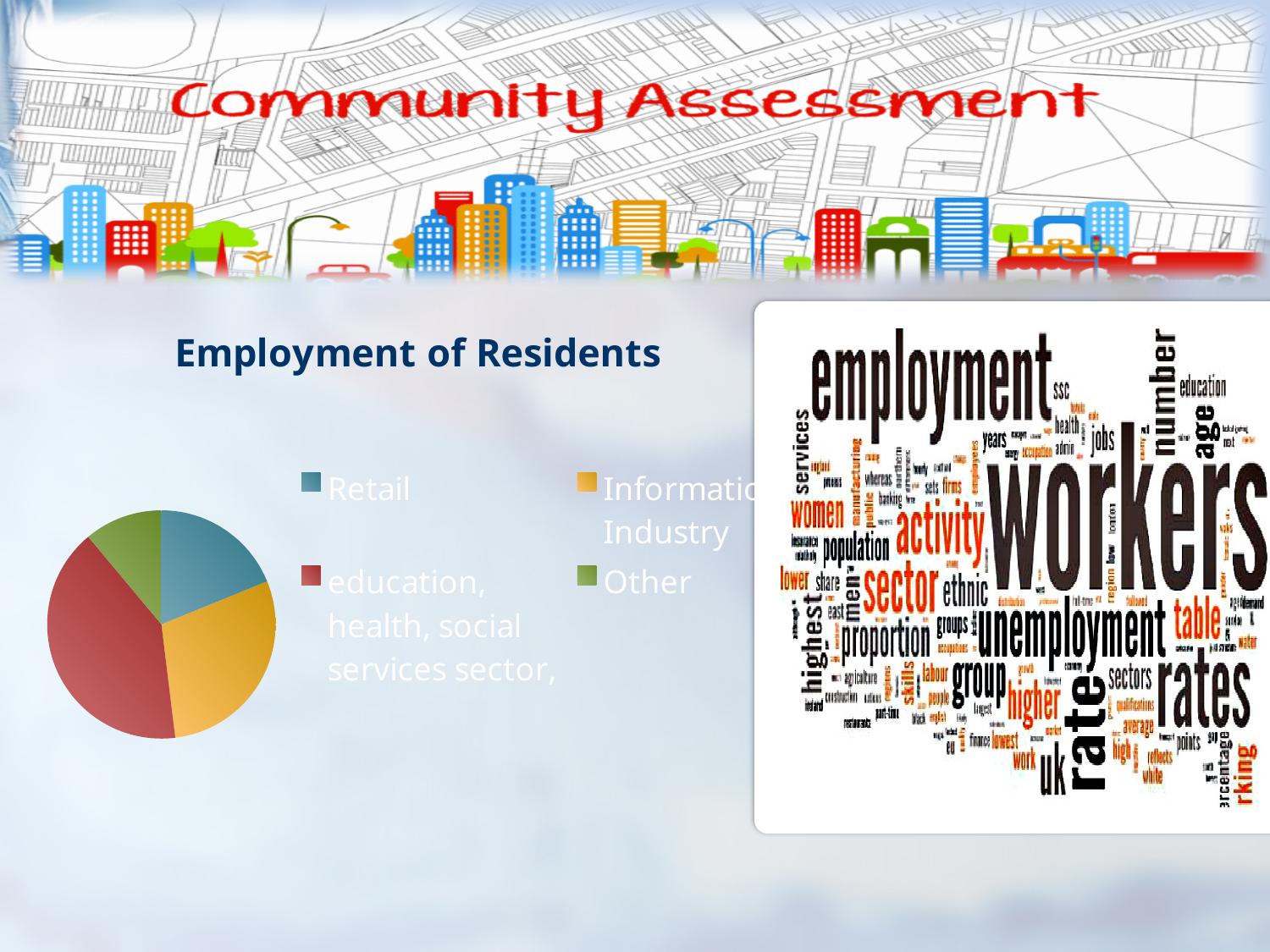
Which category has the smallest slice in the pie chart? Other Which slice is larger: education, health, social services sector or Other? education, health, social services sector What is the heading above the pie chart? Employment of Residents Which slice is larger: Retail or Other? Retail Which slice is larger: Information Industry or Other? Information Industry How many entries does the legend of the pie chart list? 4 What colour is the Retail slice in the pie chart? blue What kind of chart is shown on the slide? pie chart How many slices does the pie chart have? 4 Which category has the largest slice in the pie chart? education, health, social services sector